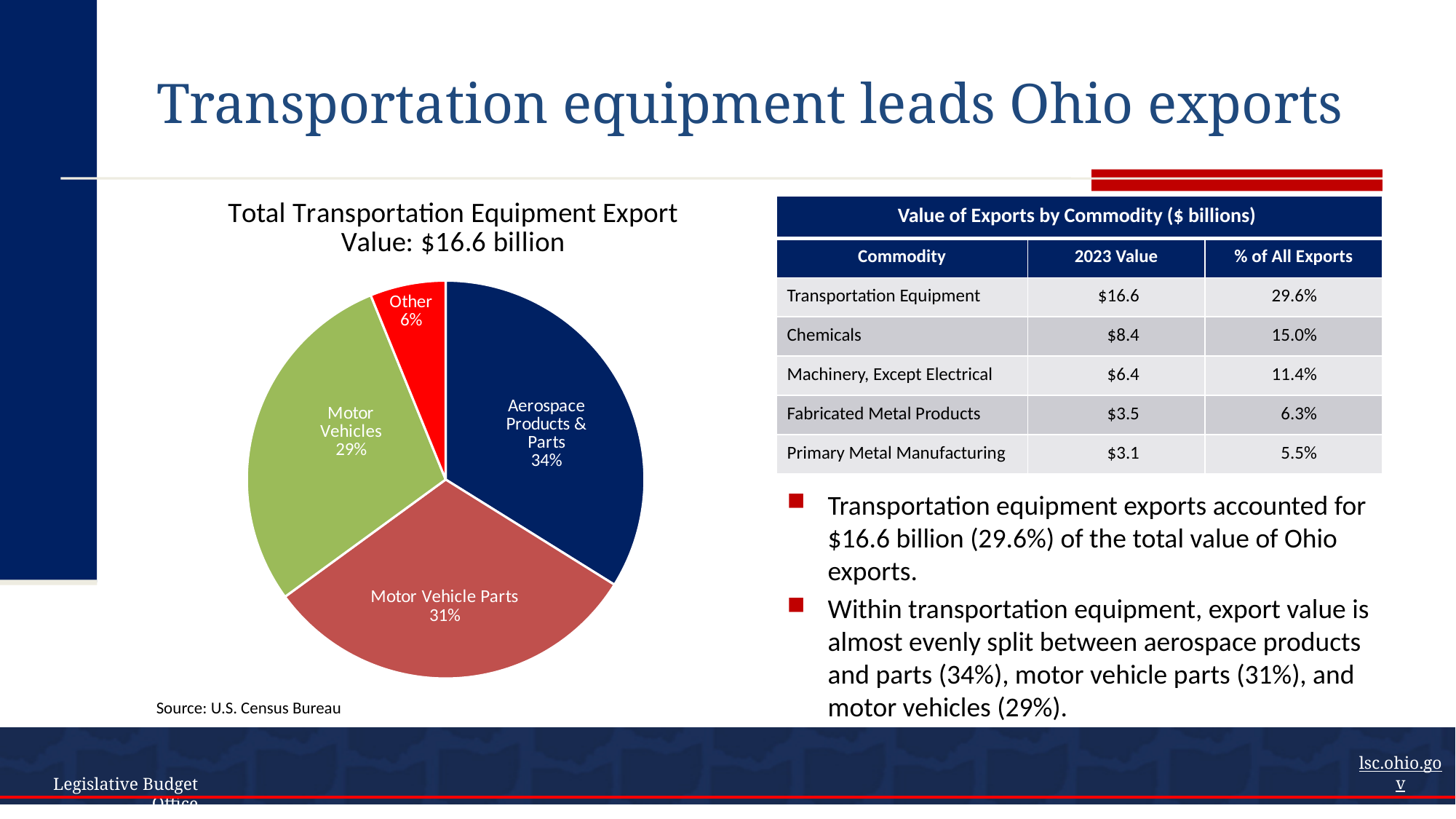
Which slice of the pie chart is the smallest? Other What share of the pie does Motor Vehicles represent? 29% Which is larger in the pie chart, Motor Vehicle Parts or Other? Motor Vehicle Parts How many slices does the pie chart have? 4 What is the difference in percentage points between the Aerospace Products & Parts slice and the Motor Vehicles slice? 5 percentage points Which slice of the pie chart is the largest? Aerospace Products & Parts What colour is the Motor Vehicles slice in the pie chart? green What share of the pie does Motor Vehicle Parts represent? 31% What kind of chart is shown on the slide? pie chart What share of the pie does Aerospace Products & Parts represent? 34% What is the title of the pie chart? Total Transportation Equipment Export Value: $16.6 billion